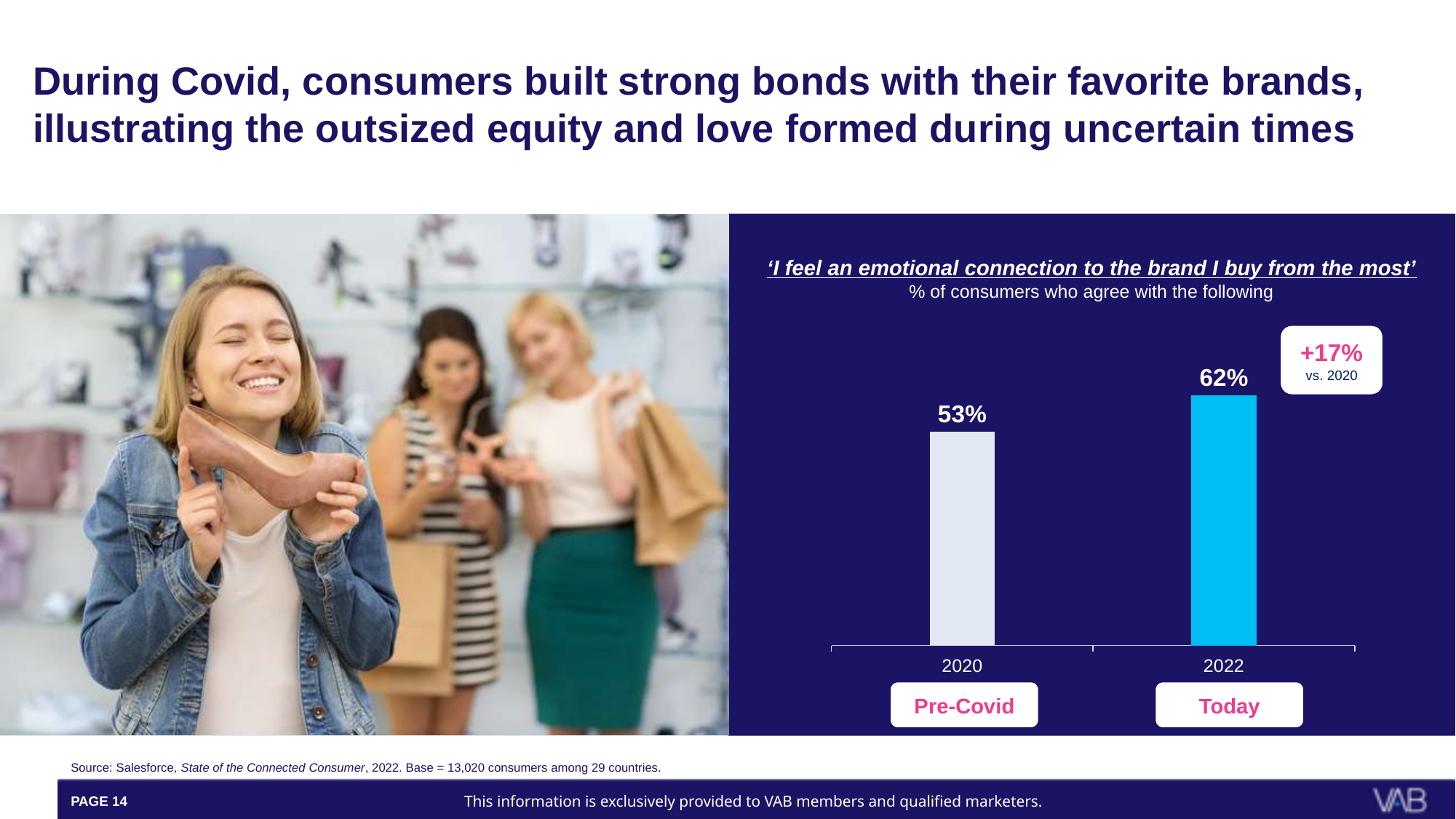
Is the value for 2022 larger or smaller than the value for 2020? larger How many bars are shown in the chart? 2 What percentage of consumers agreed with the statement in 2020? 53% Which year has the lower percentage of consumers agreeing? 2020 What percentage change vs. 2020 is shown in the callout box next to the 2022 bar? +17% What label is shown beneath the 2020 bar? Pre-Covid What type of chart is shown on the slide? bar chart What percentage of consumers agreed with the statement in 2022? 62% Do the values rise or fall from 2020 to 2022? rise Which year has the higher percentage of consumers agreeing, 2020 or 2022? 2022 By how many percentage points does the 2022 value exceed the 2020 value? 9 percentage points